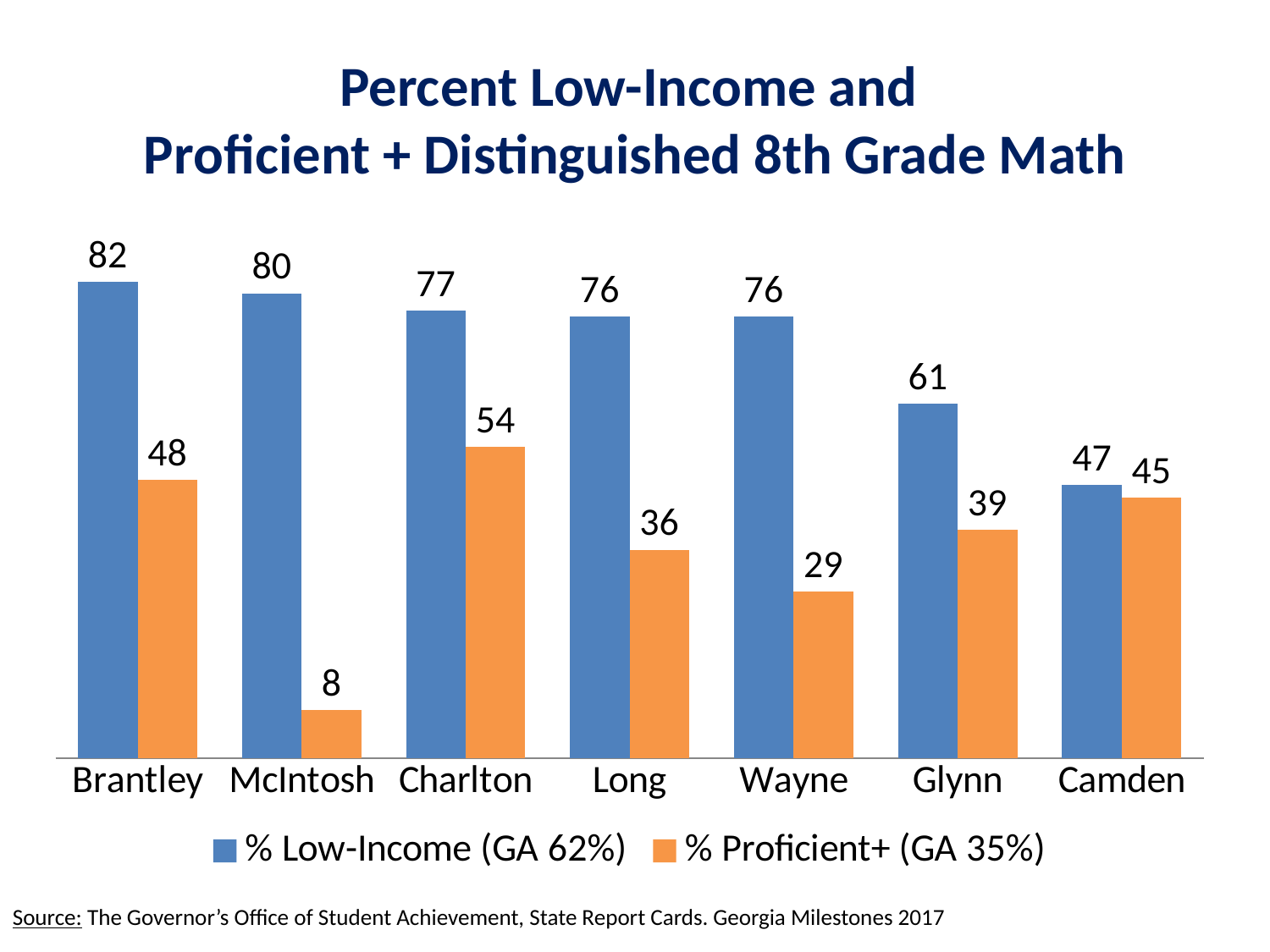
What is the % Proficient+ value for Charlton? 54 What is the difference between the % Low-Income and % Proficient+ values for Wayne? 47 How many series does the legend list? 2 Which county has the lowest % Proficient+ value? McIntosh What is the % Low-Income value for Brantley? 82 How many counties are shown on the x axis? 7 What colour are the % Proficient+ bars? Orange What is the % Proficient+ value for McIntosh? 8 Which county has the highest % Low-Income value? Brantley Do the % Low-Income values rise or fall from Brantley to Camden along the x axis? Fall Which is larger: the % Proficient+ value for Long or for Glynn? Glynn What kind of chart is shown on the slide? Bar chart